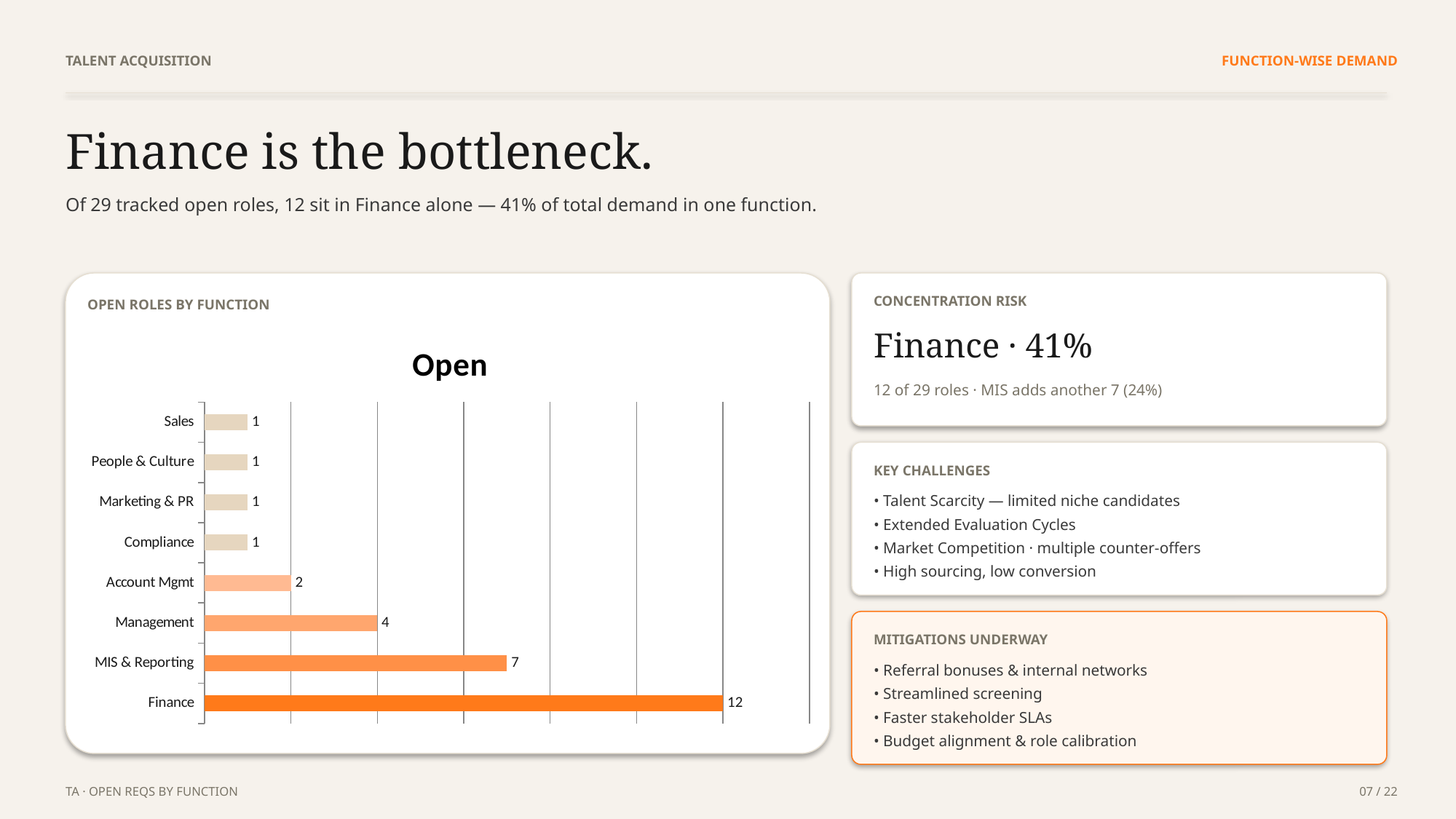
Which is larger, the value for Management or the value for Account Mgmt? Management What is the value for Management in the Open chart? 4 What is the value for Finance in the Open chart? 12 How many functions are shown in the Open chart? 8 What is the difference between the values for MIS & Reporting and Management? 3 How many functions have a value of 1 in the Open chart? 4 What is the value for Account Mgmt in the Open chart? 2 What is the title of the chart? Open What kind of chart is shown on the slide? Bar chart Which function has the highest number of open roles? Finance What is the difference between the values for Finance and MIS & Reporting? 5 What is the value for MIS & Reporting in the Open chart? 7